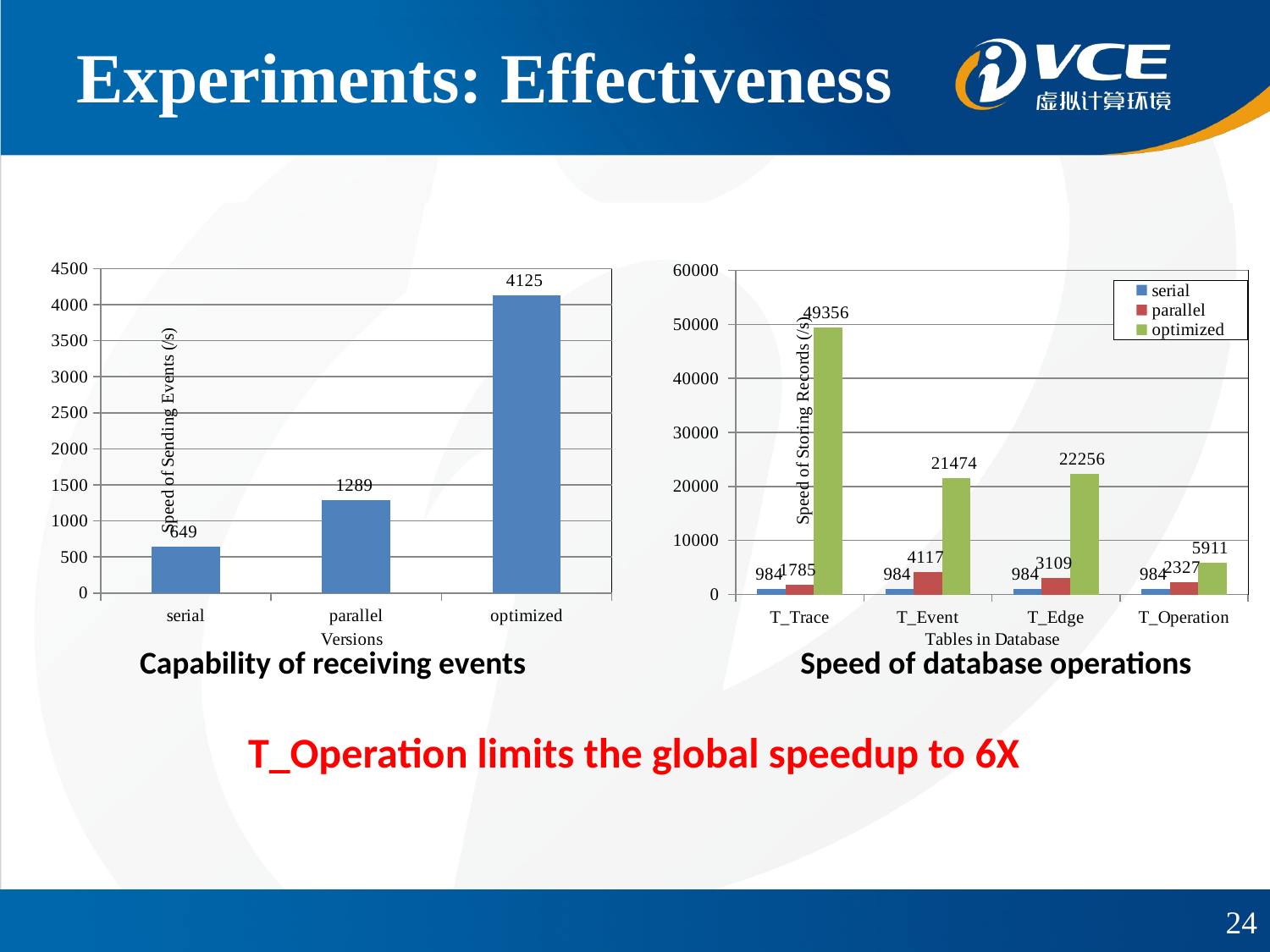
In the 'Speed of database operations' chart, what is the difference between the optimized and parallel values for T_Operation? 3584 In the 'Speed of database operations' chart, how many series does the legend list? 3 In the 'Speed of database operations' chart, which table has the lowest optimized value? T_Operation In the 'Capability of receiving events' chart, do the values rise or fall from serial to optimized? rise What kind of chart is the 'Speed of database operations' chart? bar chart In the 'Capability of receiving events' chart, what is the difference between the optimized and serial values? 3476 In the 'Speed of database operations' chart, what is the optimized value for T_Trace? 49356 In the 'Capability of receiving events' chart, which version has the highest speed of sending events? optimized In the 'Speed of database operations' chart, which is larger: the optimized value for T_Event or for T_Edge? T_Edge In the 'Capability of receiving events' chart, how many versions are shown on the x axis? 3 In the 'Capability of receiving events' chart, what is the value for the parallel version? 1289 In the 'Speed of database operations' chart, what is the parallel value for T_Edge? 3109